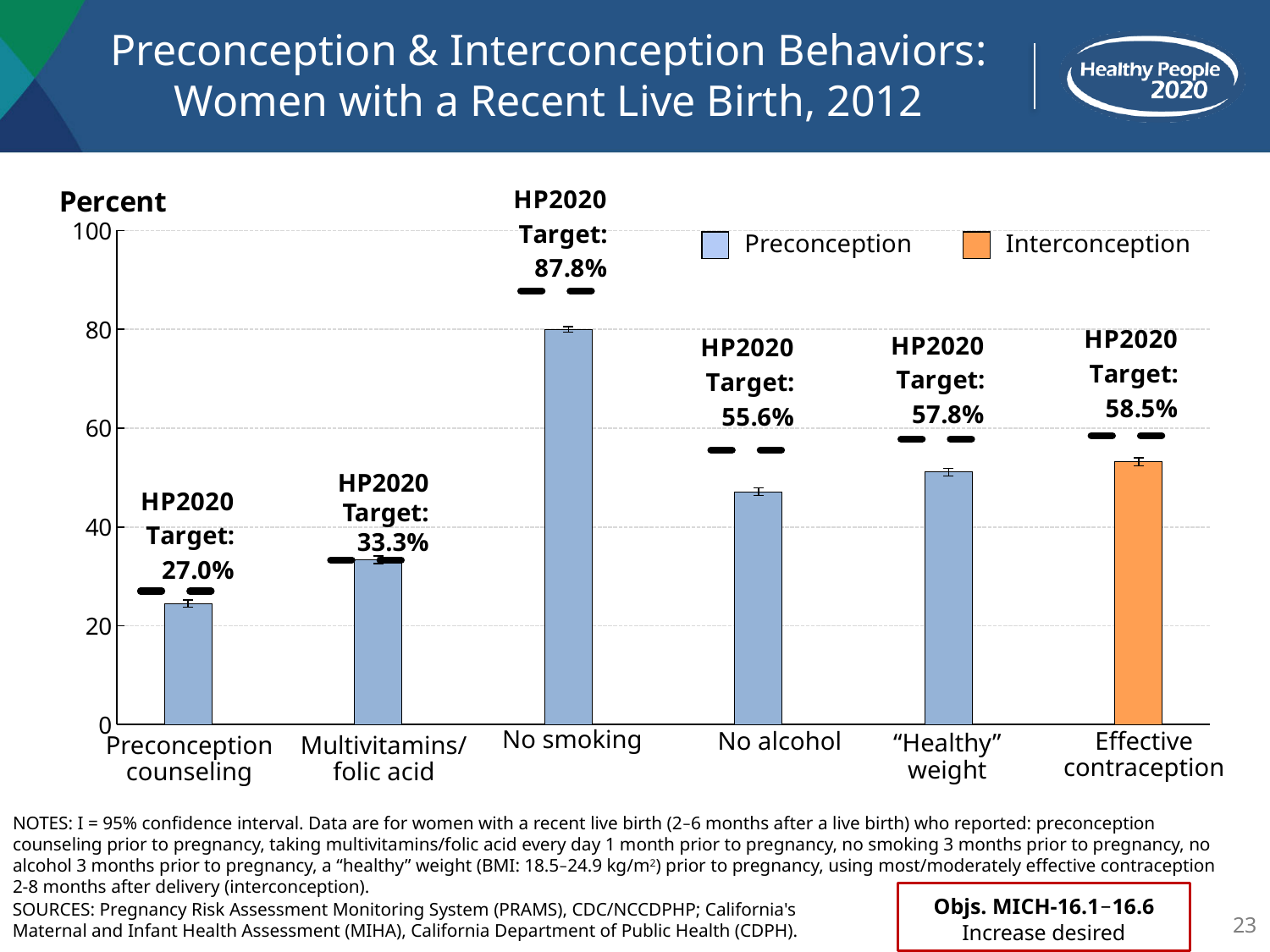
What is the HP2020 Target shown for Effective contraception? 58.5% How many series does the legend list? 2 What is the HP2020 Target shown for No smoking? 87.8% Which behavior category has the highest bar? No smoking Which behavior category has the lowest bar? Preconception counseling What kind of chart is shown on the slide? Bar chart Is the value for No smoking greater or less than 60? greater Is the value for No alcohol greater or less than 60? less Which is larger, the value for No alcohol or the value for Multivitamins/folic acid? No alcohol How many behavior categories are plotted along the x axis? 6 Which category is plotted in the Interconception series (orange bar)? Effective contraception What is the HP2020 Target shown for Preconception counseling? 27.0%